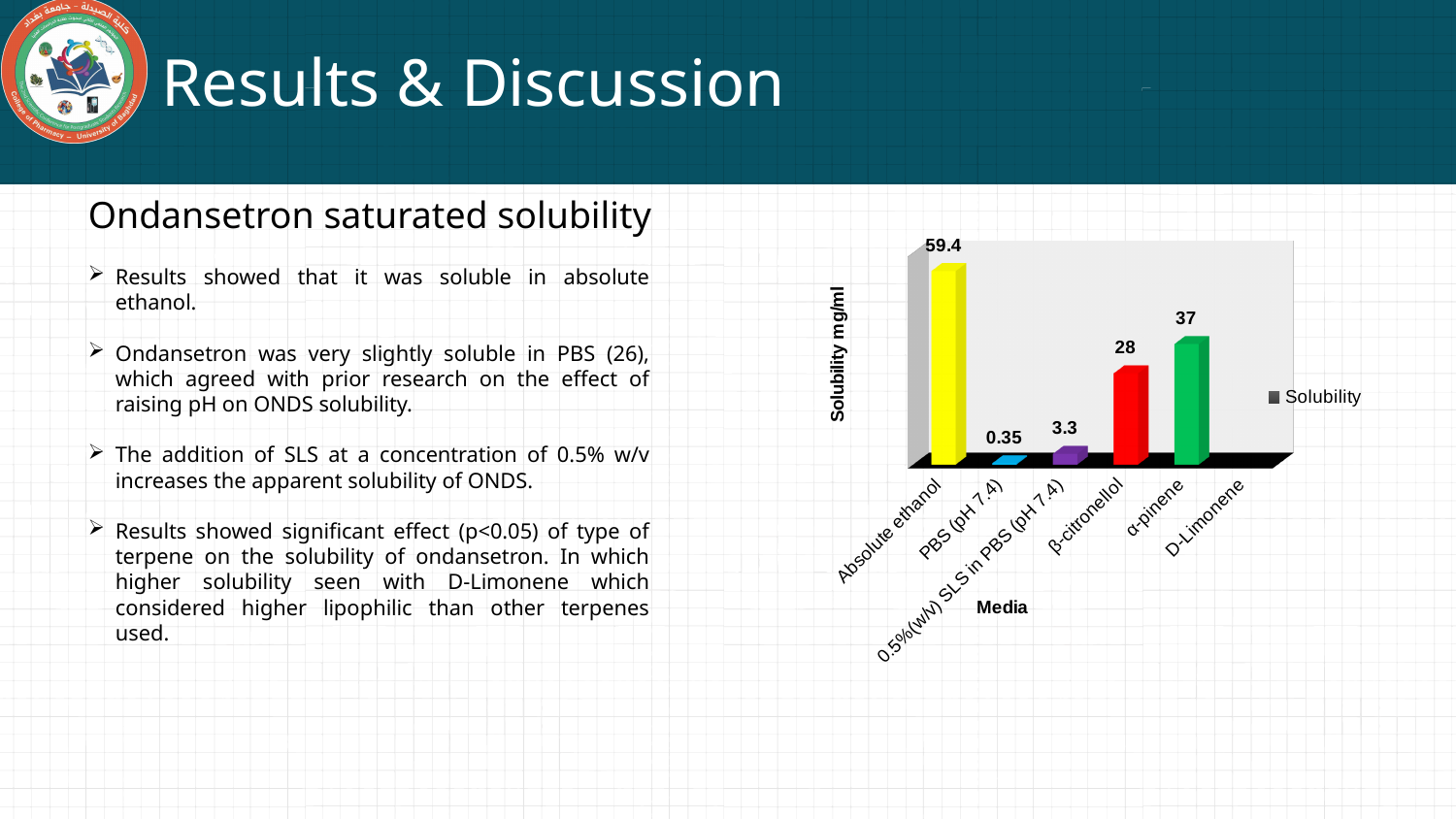
What is the difference between the solubility in Absolute ethanol and in PBS (pH 7.4)? 59.05 Which is larger, the solubility in 0.5%(w/v) SLS in PBS (pH 7.4) or in PBS (pH 7.4)? 0.5%(w/v) SLS in PBS (pH 7.4) Which media has the lowest solubility in the chart? PBS (pH 7.4) What type of chart is shown on the slide? bar chart How many series does the chart legend list? 1 What is the solubility value shown for 0.5%(w/v) SLS in PBS (pH 7.4)? 3.3 How many media categories are labelled on the x axis of the chart? 6 What is the solubility value shown for PBS (pH 7.4)? 0.35 What is the title of the vertical axis of the chart? Solubility mg/ml Which media has the highest solubility in the chart? Absolute ethanol What is the solubility value shown for Absolute ethanol? 59.4 What is the difference between the two data labels 37 and 28 shown on the chart? 9